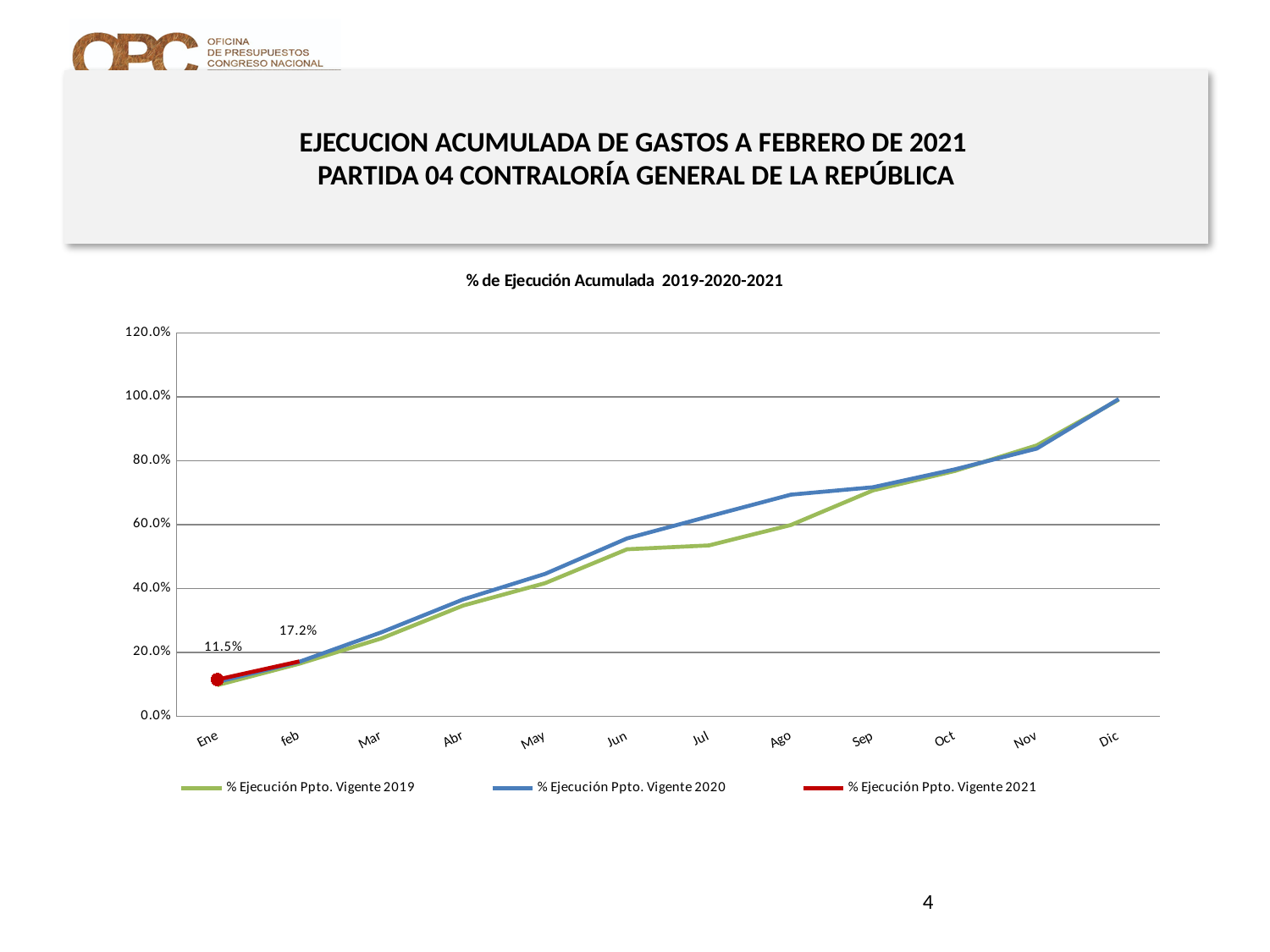
What is the title of the chart? % de Ejecución Acumulada 2019-2020-2021 Does the % Ejecución Ppto. Vigente 2020 line rise or fall from Ene to Dic? rise What is the value for % Ejecución Ppto. Vigente 2021 in feb? 17.2% What kind of chart is shown on the slide? line chart How many series does the legend list? 3 How many months are shown on the x axis? 12 What colour is the line for % Ejecución Ppto. Vigente 2021? red Is the value for % Ejecución Ppto. Vigente 2019 in Jul greater or less than 60.0%? less Is the value for % Ejecución Ppto. Vigente 2020 in Dic greater or less than 80.0%? greater What is the value for % Ejecución Ppto. Vigente 2021 in Ene? 11.5% In Ago, which series has the larger value: % Ejecución Ppto. Vigente 2019 or % Ejecución Ppto. Vigente 2020? % Ejecución Ppto. Vigente 2020 What is the difference between the feb and Ene values for % Ejecución Ppto. Vigente 2021? 5.7%